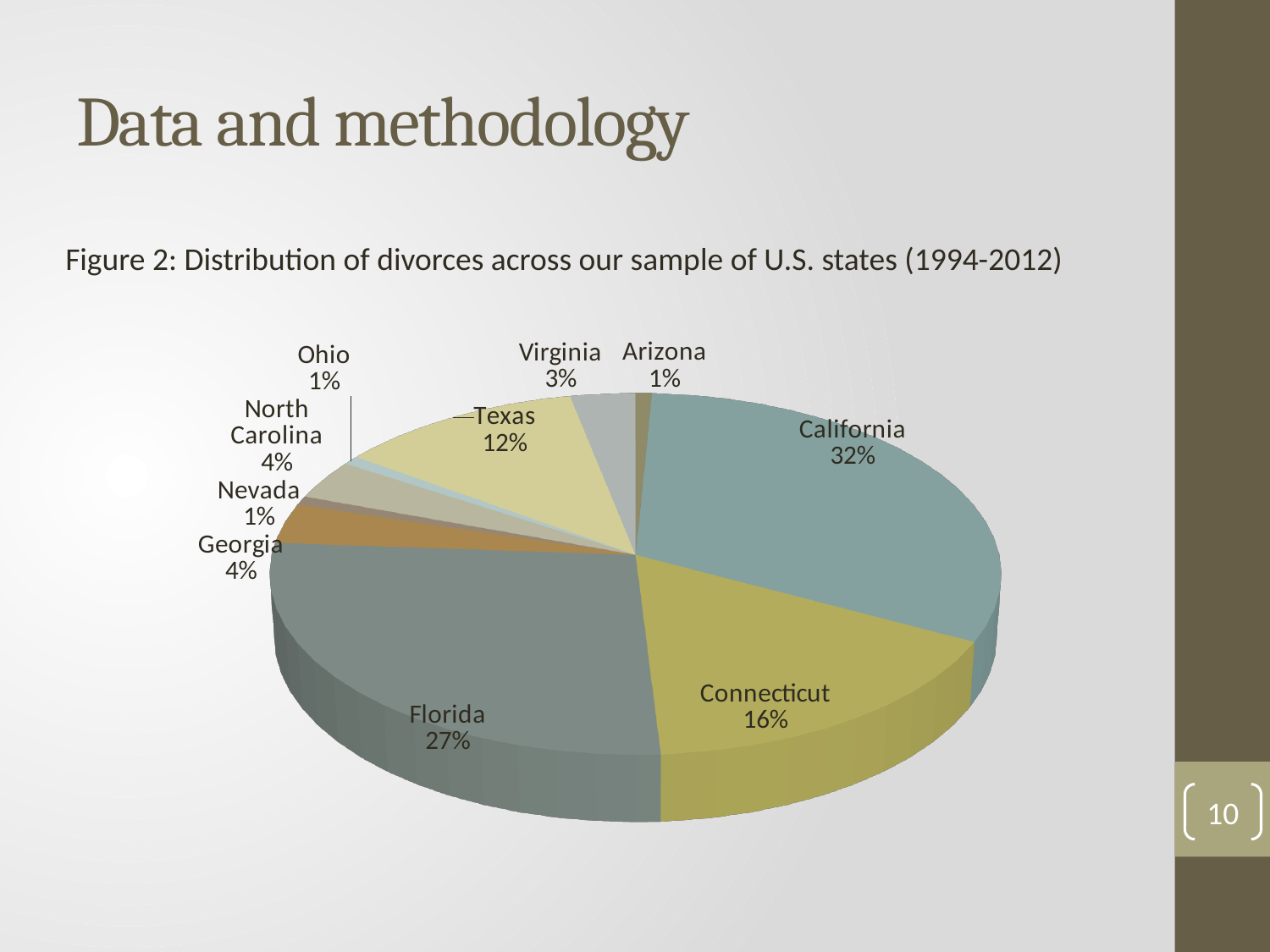
What percentage of the pie chart is Florida? 27% What share does Texas have in the pie chart? 12% What is the difference in percentage points between California's and Florida's shares? 5 What share of the pie does Virginia represent? 3% Which has a larger share, Connecticut or Texas? Connecticut What percentage is shown for Connecticut? 16% What is the caption of the figure on the slide? Figure 2: Distribution of divorces across our sample of U.S. states (1994-2012) What kind of chart is shown on the slide? Pie chart How many states are shown in the pie chart? 10 What is the combined share of Florida and Connecticut? 43% Which state has the largest slice of the pie chart? California What share of divorces does California account for in the pie chart? 32%